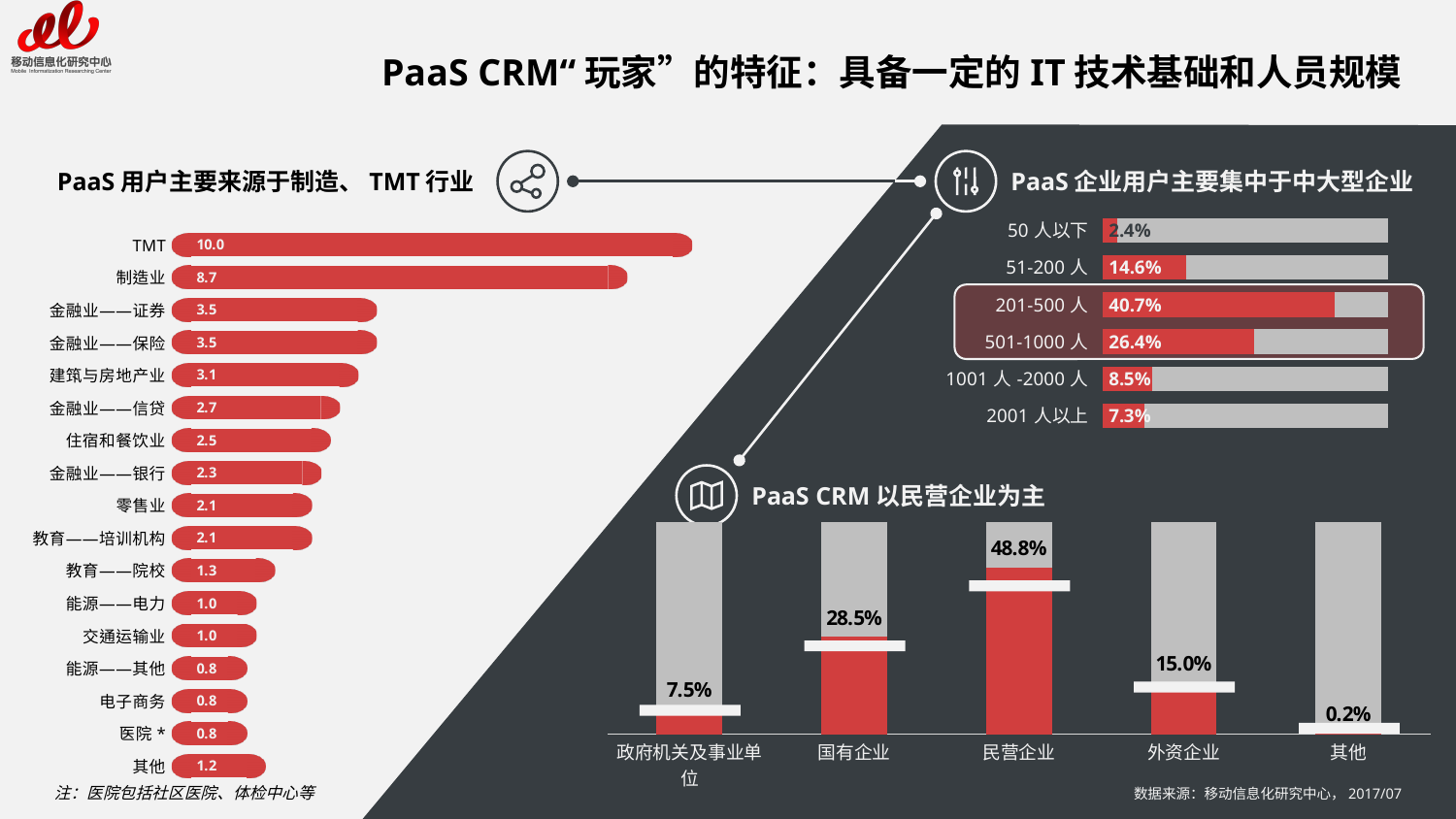
In the chart titled "PaaS 企业用户主要集中于中大型企业", what is the difference between the values for 201-500 人 and 501-1000 人? 14.3% In the chart titled "PaaS 企业用户主要集中于中大型企业", which category has the lowest value? 50 人以下 What kind of chart is the one titled "PaaS CRM 以民营企业为主"? Bar chart In the chart titled "PaaS 企业用户主要集中于中大型企业", how many categories are shown? 6 In the chart titled "PaaS CRM 以民营企业为主", what is the value for 民营企业? 48.8% In the chart titled "PaaS 用户主要来源于制造、TMT 行业", what is the difference between the values for TMT and 制造业? 1.3 In the chart titled "PaaS 用户主要来源于制造、TMT 行业", which category has the highest value? TMT In the chart titled "PaaS 用户主要来源于制造、TMT 行业", how many categories are shown? 17 In the chart titled "PaaS 企业用户主要集中于中大型企业", what is the value for 201-500 人? 40.7% In the chart titled "PaaS CRM 以民营企业为主", which is larger, 国有企业 or 外资企业? 国有企业 In the chart titled "PaaS 用户主要来源于制造、TMT 行业", what is the value for TMT? 10.0 In the chart titled "PaaS 用户主要来源于制造、TMT 行业", what is the value for 制造业? 8.7